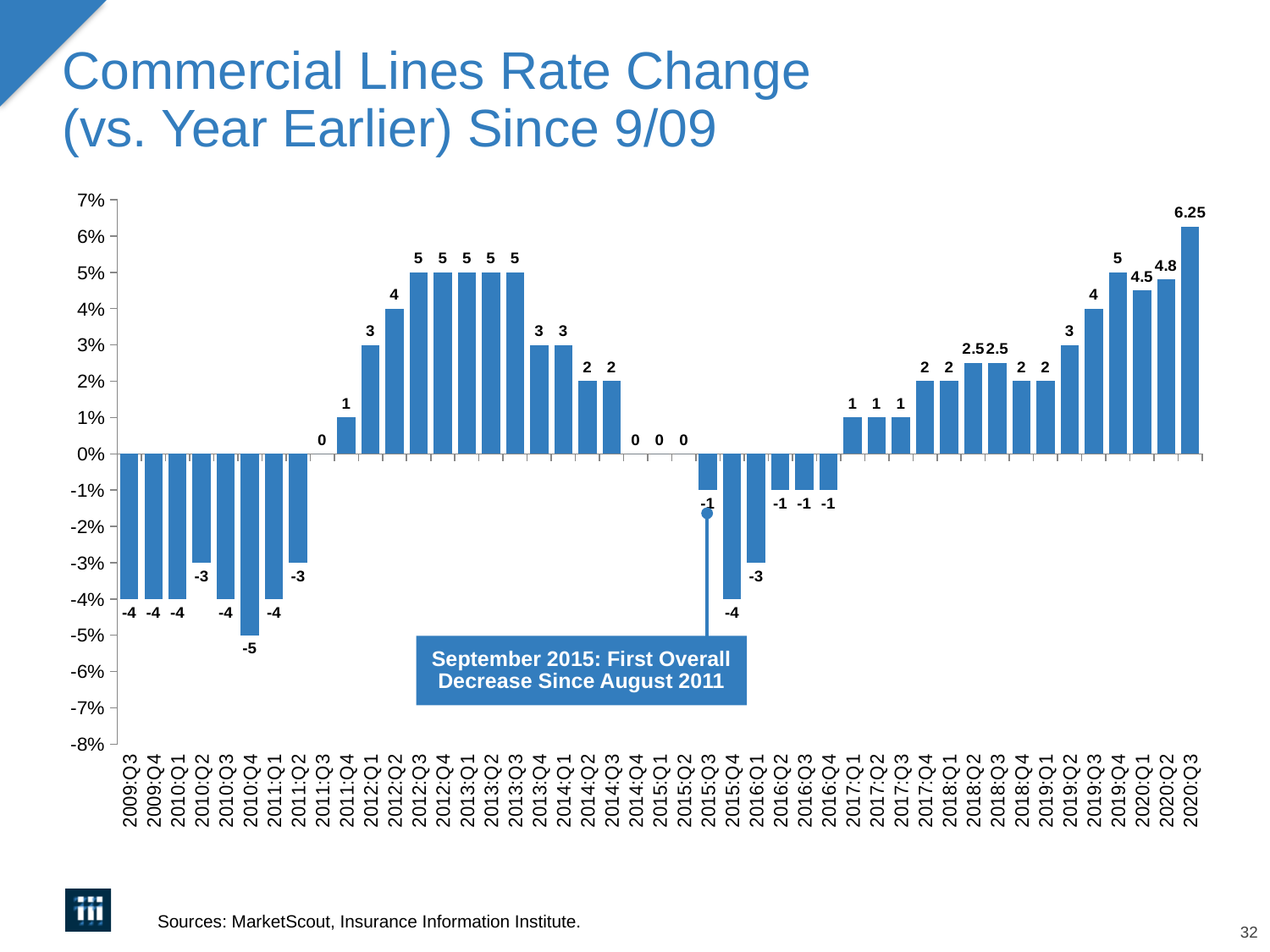
What is the difference between the values for 2020:Q3 and 2020:Q2? 1.45 What is the value for 2020:Q3? 6.25 What is the value for 2018:Q2? 2.5 What is the value for 2010:Q4? -5 Which is larger, the value for 2019:Q4 or the value for 2020:Q1? 2019:Q4 Which quarter has the lowest value? 2010:Q4 What does the callout box on the chart say? September 2015: First Overall Decrease Since August 2011 What type of chart is shown on the slide? Bar chart Do the values rise or fall from 2017:Q1 to 2020:Q3? Rise How many quarters are plotted on the x axis? 45 What is the value for 2020:Q2? 4.8 Which quarter has the highest value? 2020:Q3